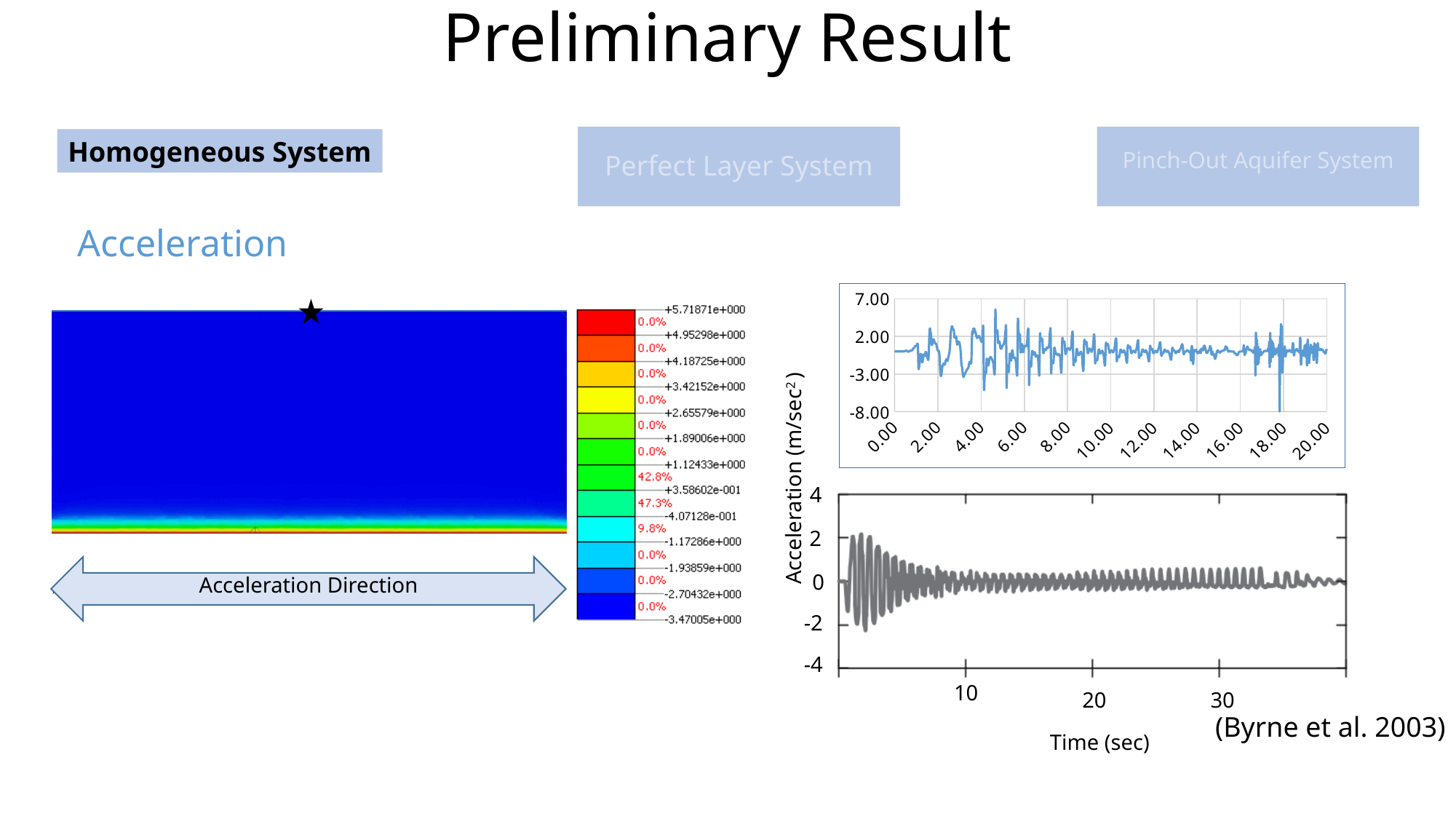
How many tick labels are shown on the x-axis of the top right line chart? 11 On the top right line chart, what is the largest time value labelled on the x-axis? 20.00 What kind of chart is the blue chart at the top right of the slide? line chart On the bottom right chart (Byrne et al. 2003), does the amplitude of the oscillations increase or decrease from the start of the record toward 10 seconds? decrease On the bottom right chart (Byrne et al. 2003), is the peak acceleration greater or less than 4? less On the top right line chart, what is the highest tick value shown on the y-axis? 7.00 In the colour legend next to the contour plot, what is the highest value listed? +5.71871e+000 Which source is cited for the bottom right chart? Byrne et al. 2003 What is the y-axis label of the bottom right chart? Acceleration (m/sec²) On the top right line chart, what is the lowest tick value shown on the y-axis? -8.00 In the colour legend next to the contour plot, what is the lowest value listed? -3.47005e+000 In the colour legend next to the contour plot, what is the largest percentage shown? 47.3%